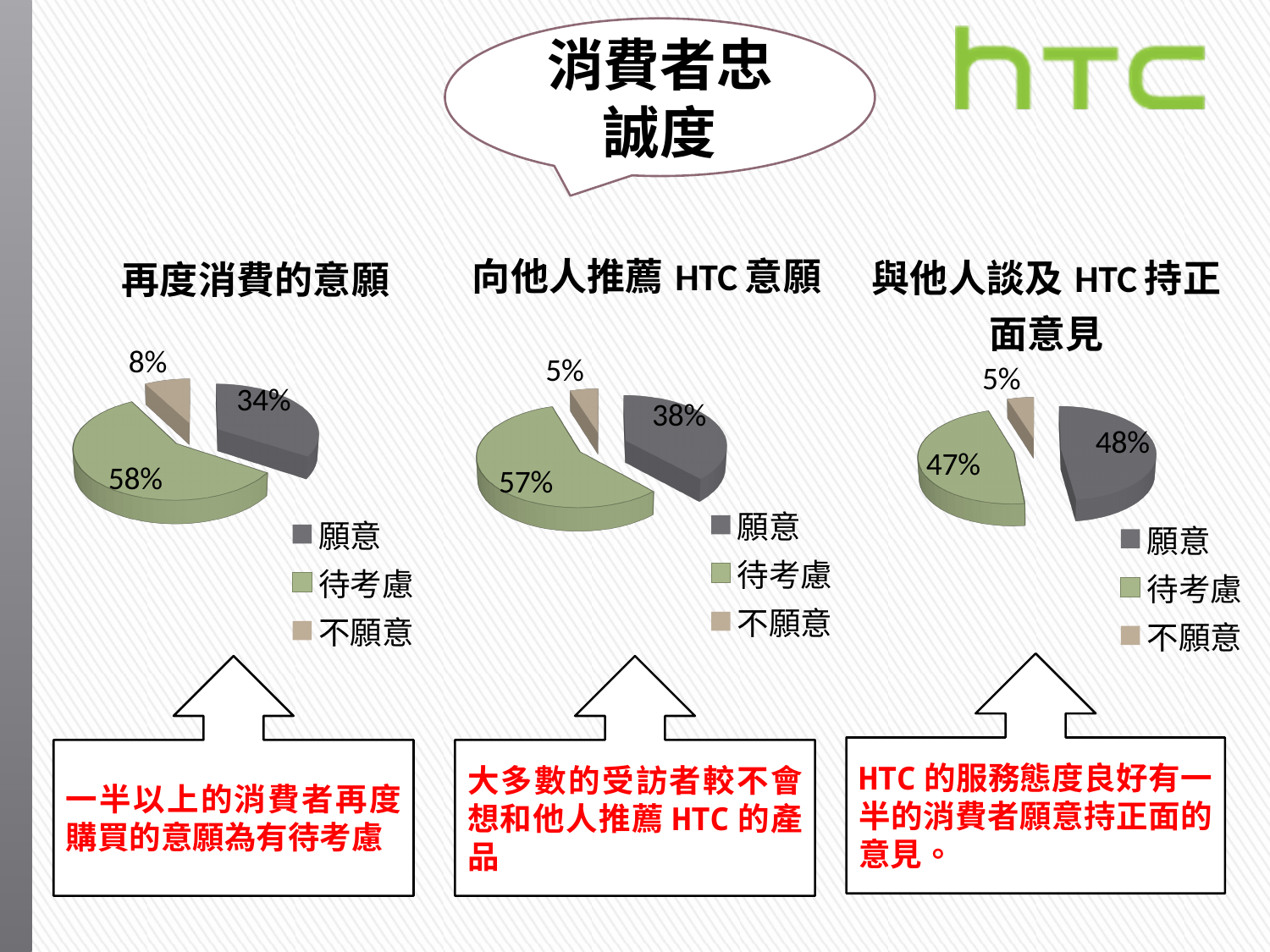
In the pie chart titled 向他人推薦 HTC 意願, which is larger, the share for 願意 or the share for 待考慮? 待考慮 In the pie chart titled 再度消費的意願, what percentage is shown for 不願意? 8% In the pie chart titled 向他人推薦 HTC 意願, what percentage is shown for 願意? 38% In the pie chart titled 與他人談及 HTC 持正面意見, what percentage is shown for 願意? 48% In the pie chart titled 與他人談及 HTC 持正面意見, which category has the smallest share? 不願意 In the pie chart titled 與他人談及 HTC 持正面意見, what percentage is shown for 不願意? 5% In the pie chart titled 再度消費的意願, which category has the largest share? 待考慮 How many slices does the pie chart titled 再度消費的意願 have? 3 In the pie chart titled 再度消費的意願, what is the difference between the 待考慮 share and the 願意 share? 24% In the pie chart titled 再度消費的意願, what percentage is shown for 待考慮? 58% In the pie chart titled 向他人推薦 HTC 意願, which category has the smallest share? 不願意 What type of chart is used for 向他人推薦 HTC 意願? Pie chart